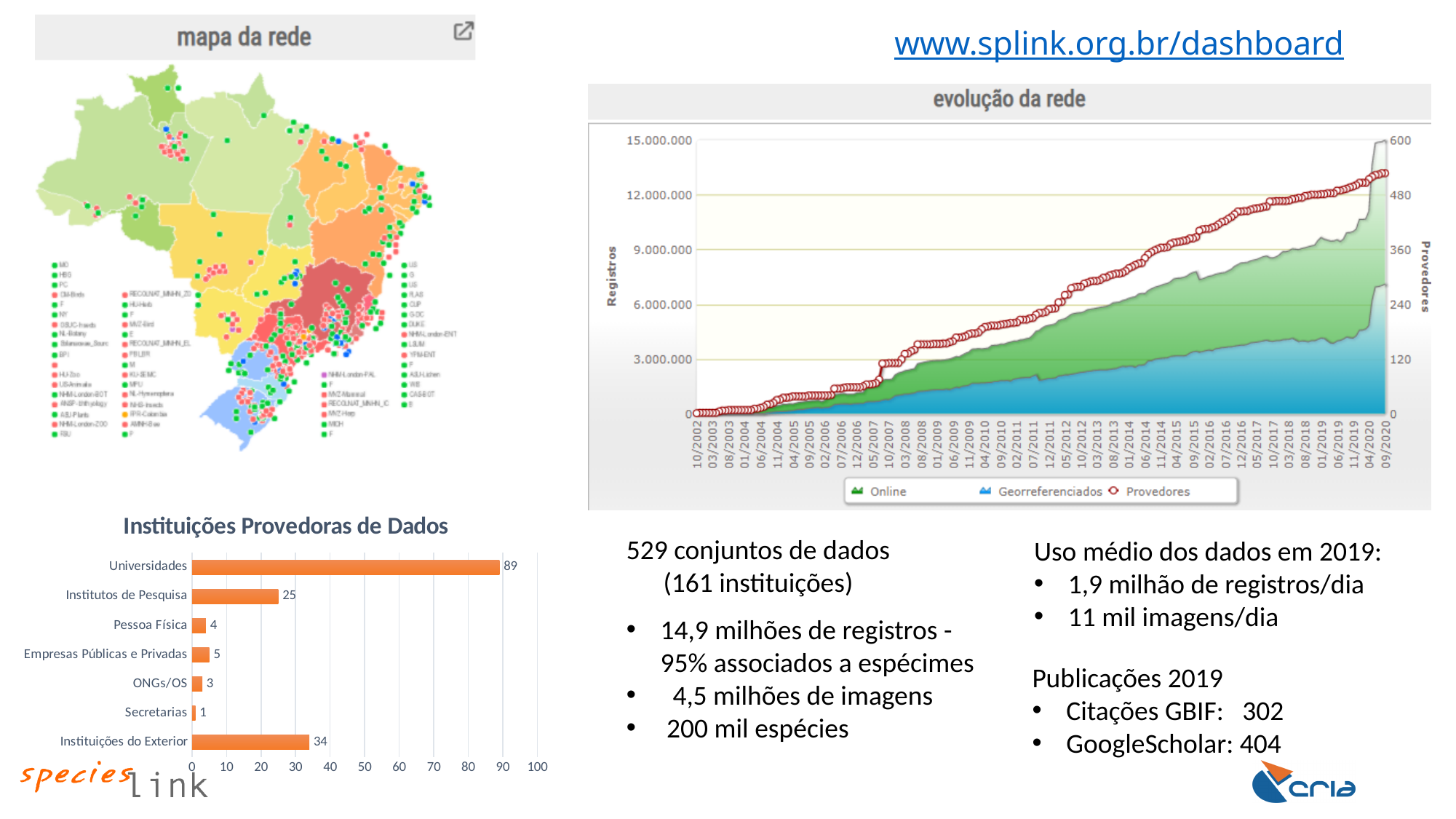
In the 'Instituições Provedoras de Dados' chart, which category has the lowest value? Secretarias What are the legend entries of the 'evolução da rede' chart? Online, Georreferenciados, Provedores How many series does the legend of the 'evolução da rede' chart list? 3 How many categories are shown in the 'Instituições Provedoras de Dados' chart? 7 In the 'Instituições Provedoras de Dados' chart, which is larger: Empresas Públicas e Privadas or Pessoa Física? Empresas Públicas e Privadas What kind of chart is 'Instituições Provedoras de Dados'? Bar chart In the 'evolução da rede' chart, does the Provedores series rise or fall over time along the x axis? Rise In the 'Instituições Provedoras de Dados' chart, which category has the highest value? Universidades In the 'Instituições Provedoras de Dados' chart, what is the difference between Universidades and Instituições do Exterior? 55 In the 'Instituições Provedoras de Dados' chart, what is the value for Universidades? 89 In the 'Instituições Provedoras de Dados' chart, what is the value for Instituições do Exterior? 34 In the 'Instituições Provedoras de Dados' chart, what is the value for Institutos de Pesquisa? 25